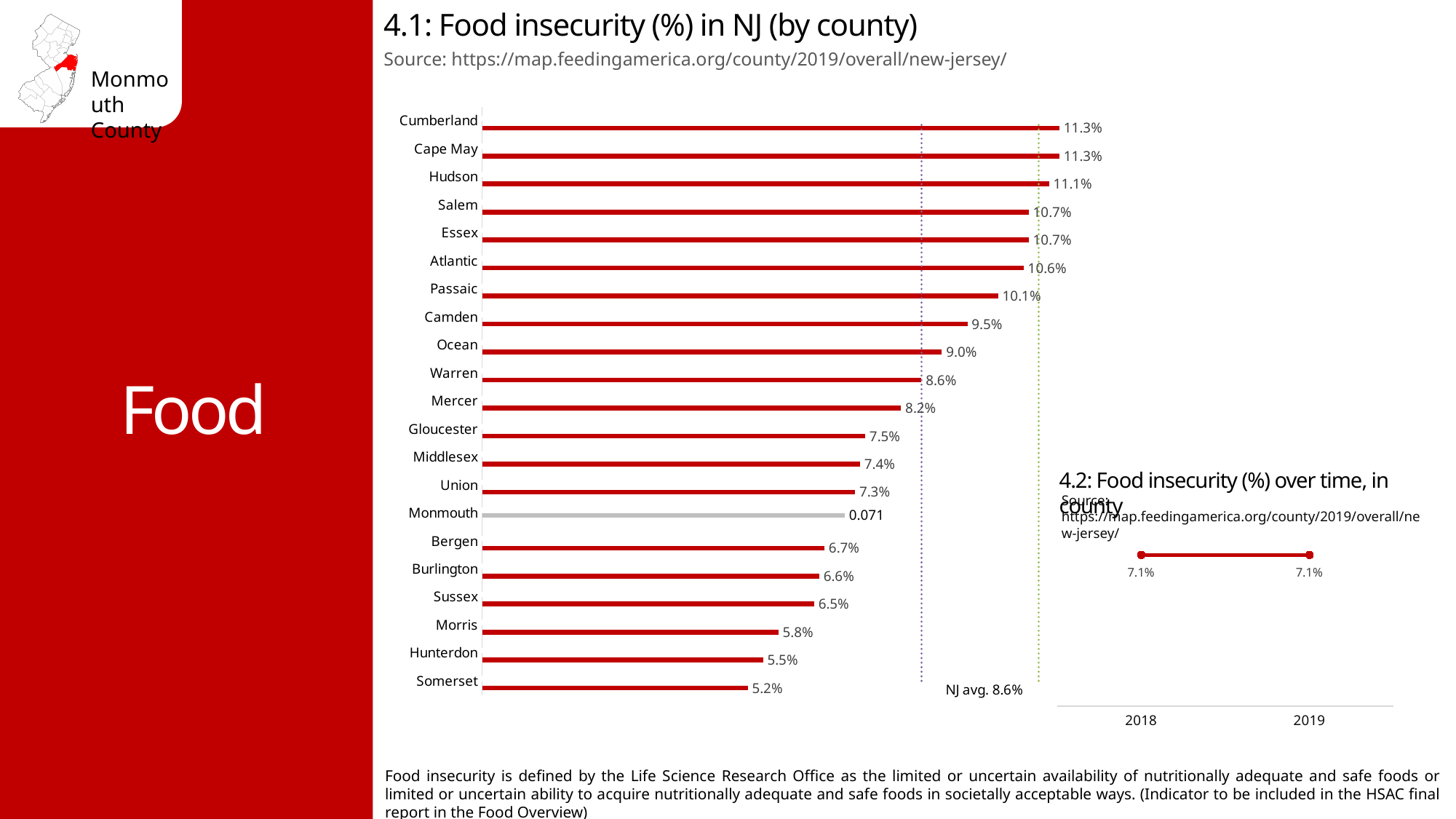
In the chart '4.1: Food insecurity (%) in NJ (by county)', what NJ average value is labelled on the chart? NJ avg. 8.6% In the chart '4.1: Food insecurity (%) in NJ (by county)', what data label is shown for Monmouth? 0.071 In the chart '4.1: Food insecurity (%) in NJ (by county)', what is the difference between Passaic and Mercer? 1.9% In the chart '4.1: Food insecurity (%) in NJ (by county)', what is the value for Hudson? 11.1% In the chart '4.2: Food insecurity (%) over time, in county', how many years are plotted? 2 In the chart '4.1: Food insecurity (%) in NJ (by county)', what is the value for Camden? 9.5% In the chart '4.1: Food insecurity (%) in NJ (by county)', which county has the lowest value? Somerset In the chart '4.1: Food insecurity (%) in NJ (by county)', how many counties are plotted? 21 In the chart '4.2: Food insecurity (%) over time, in county', what is the value for 2019? 7.1% In the chart '4.1: Food insecurity (%) in NJ (by county)', which is larger, Ocean or Gloucester? Ocean In the chart '4.2: Food insecurity (%) over time, in county', does the value rise, fall or stay the same from 2018 to 2019? Stays the same What kind of chart is '4.1: Food insecurity (%) in NJ (by county)'? Bar chart